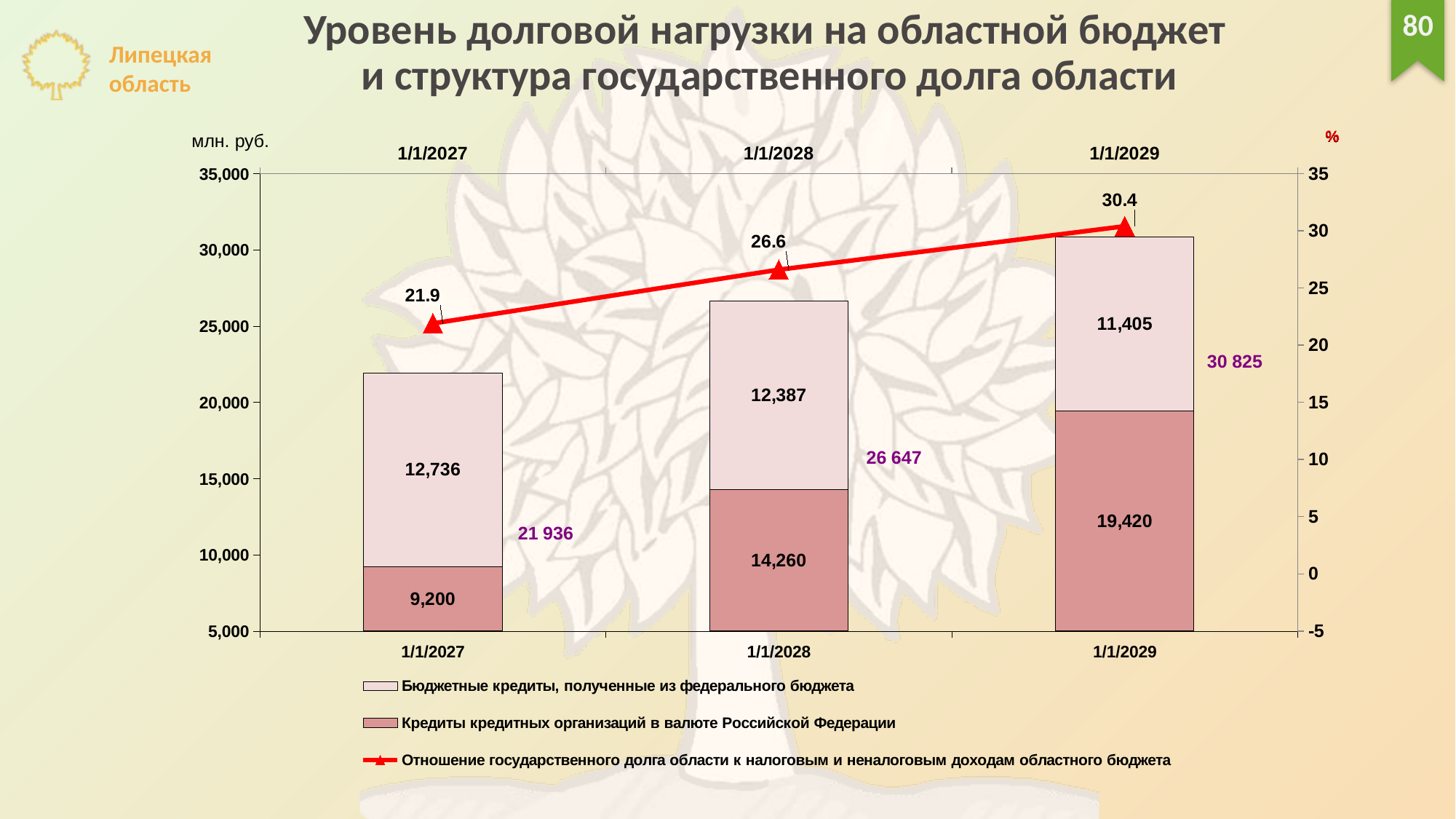
What is the value of 'Бюджетные кредиты, полученные из федерального бюджета' on 1/1/2028? 12,387 What is the value of 'Кредиты кредитных организаций в валюте Российской Федерации' on 1/1/2027? 9,200 How does the line series 'Отношение государственного долга области к налоговым и неналоговым доходам областного бюджета' change from 1/1/2027 to 1/1/2029? It rises How many dates (categories) are shown on the x axis of the chart? 3 What is the difference between the 'Кредиты кредитных организаций' values on 1/1/2029 and 1/1/2027? 10,220 Which is larger on 1/1/2028: 'Бюджетные кредиты, полученные из федерального бюджета' or 'Кредиты кредитных организаций в валюте Российской Федерации'? Кредиты кредитных организаций в валюте Российской Федерации On which date is the value of 'Кредиты кредитных организаций в валюте Российской Федерации' highest? 1/1/2029 What is the total of the stacked bar for 1/1/2028 as printed on the slide? 26 647 On which date is the value of 'Бюджетные кредиты, полученные из федерального бюджета' lowest? 1/1/2029 How many series does the chart legend list? 3 What is the value of the line series 'Отношение государственного долга области к налоговым и неналоговым доходам областного бюджета' on 1/1/2029? 30.4 What unit is shown on the left vertical axis of the chart? млн. руб.